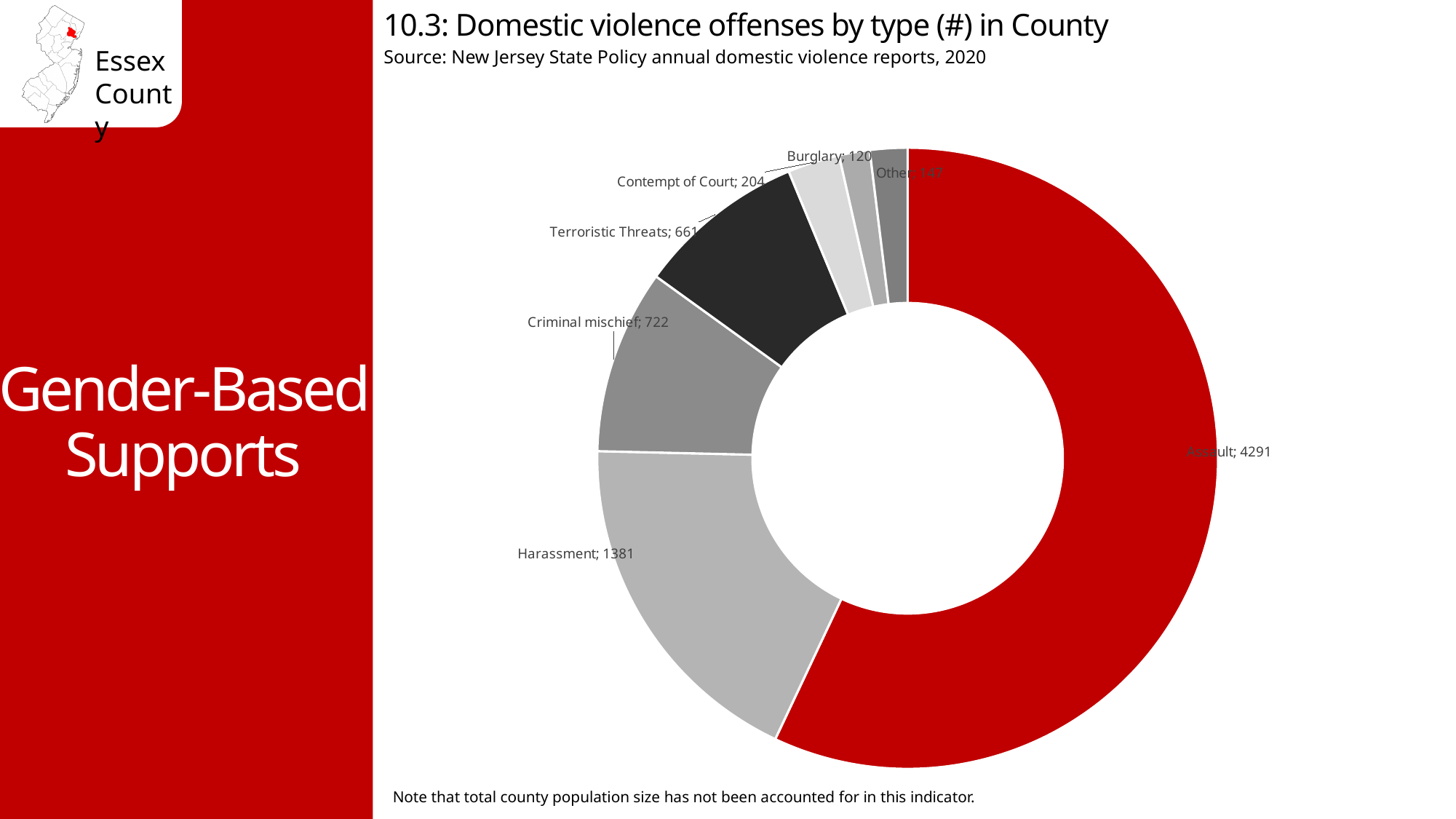
What is the value for Criminal mischief? 722 How many offense types are shown in the chart? 7 What is the source cited for the chart? New Jersey State Policy annual domestic violence reports, 2020 What is the value for Contempt of Court? 204 What is the value for Harassment? 1381 Which is larger, Criminal mischief or Terroristic Threats? Criminal mischief What is the difference between the Assault and Harassment values? 2910 Which offense type has the lowest number of offenses? Burglary What kind of chart is shown on the slide? Doughnut (pie) chart What is the value for Terroristic Threats? 661 Which offense type has the highest number of offenses? Assault How many domestic violence offenses of type Assault are shown? 4291